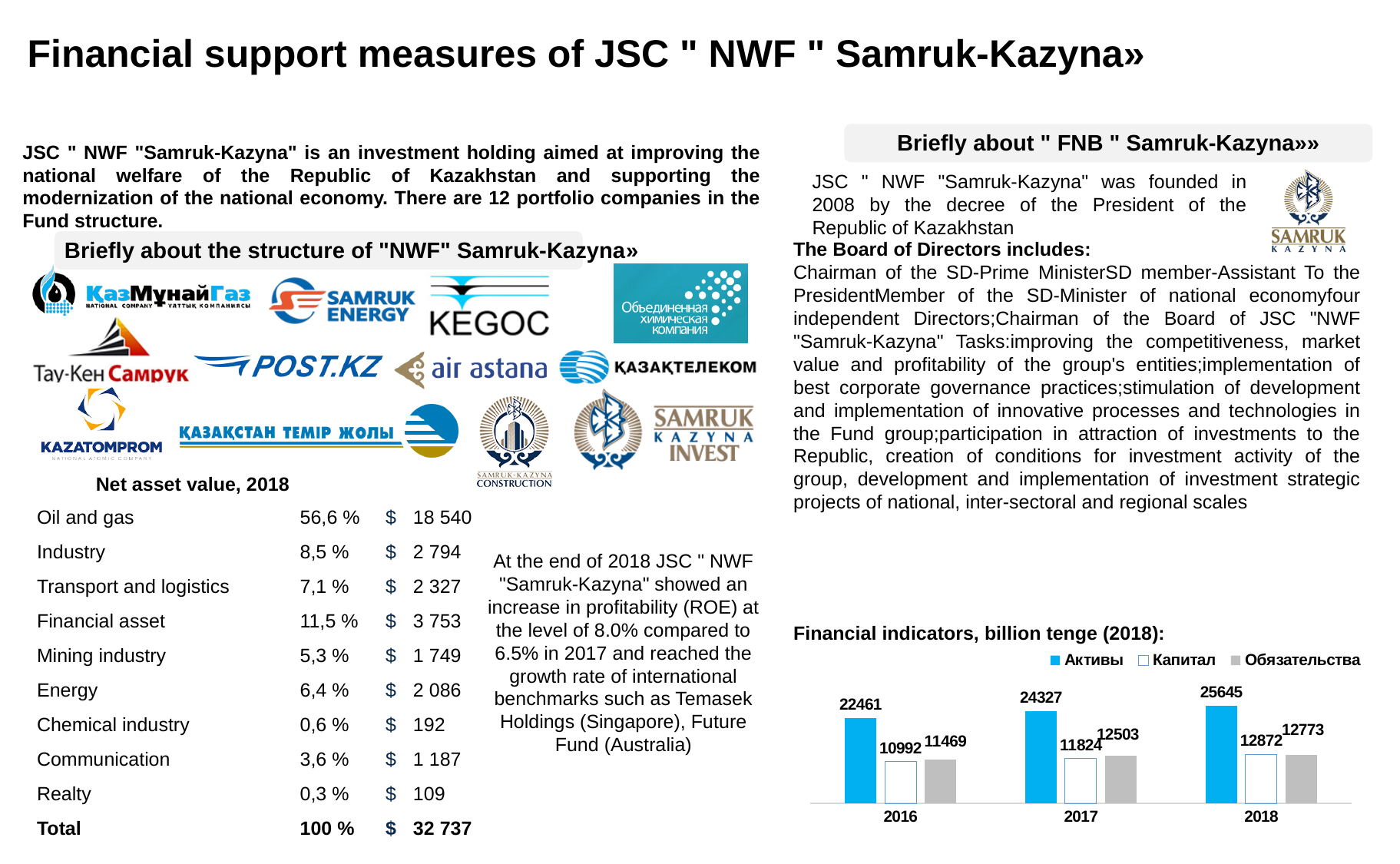
What is the difference between Активы in 2018 and Активы in 2016 in the "Financial indicators" chart? 3184 How many series does the legend of the "Financial indicators" chart list? 3 Which is larger in 2017 in the "Financial indicators" chart: Капитал or Обязательства? Обязательства Which series is shown in grey in the "Financial indicators" chart? Обязательства In which year is Активы highest in the "Financial indicators" chart? 2018 Does Активы rise or fall from 2016 to 2018 in the "Financial indicators" chart? rise What is the value of Обязательства in 2017 in the "Financial indicators" chart? 12503 What is the value of Активы in 2018 in the "Financial indicators" chart? 25645 In which year is Капитал lowest in the "Financial indicators" chart? 2016 How many years are shown on the x axis of the "Financial indicators" chart? 3 What type of chart is shown under "Financial indicators, billion tenge (2018)"? bar chart What is the value of Капитал in 2016 in the "Financial indicators" chart? 10992